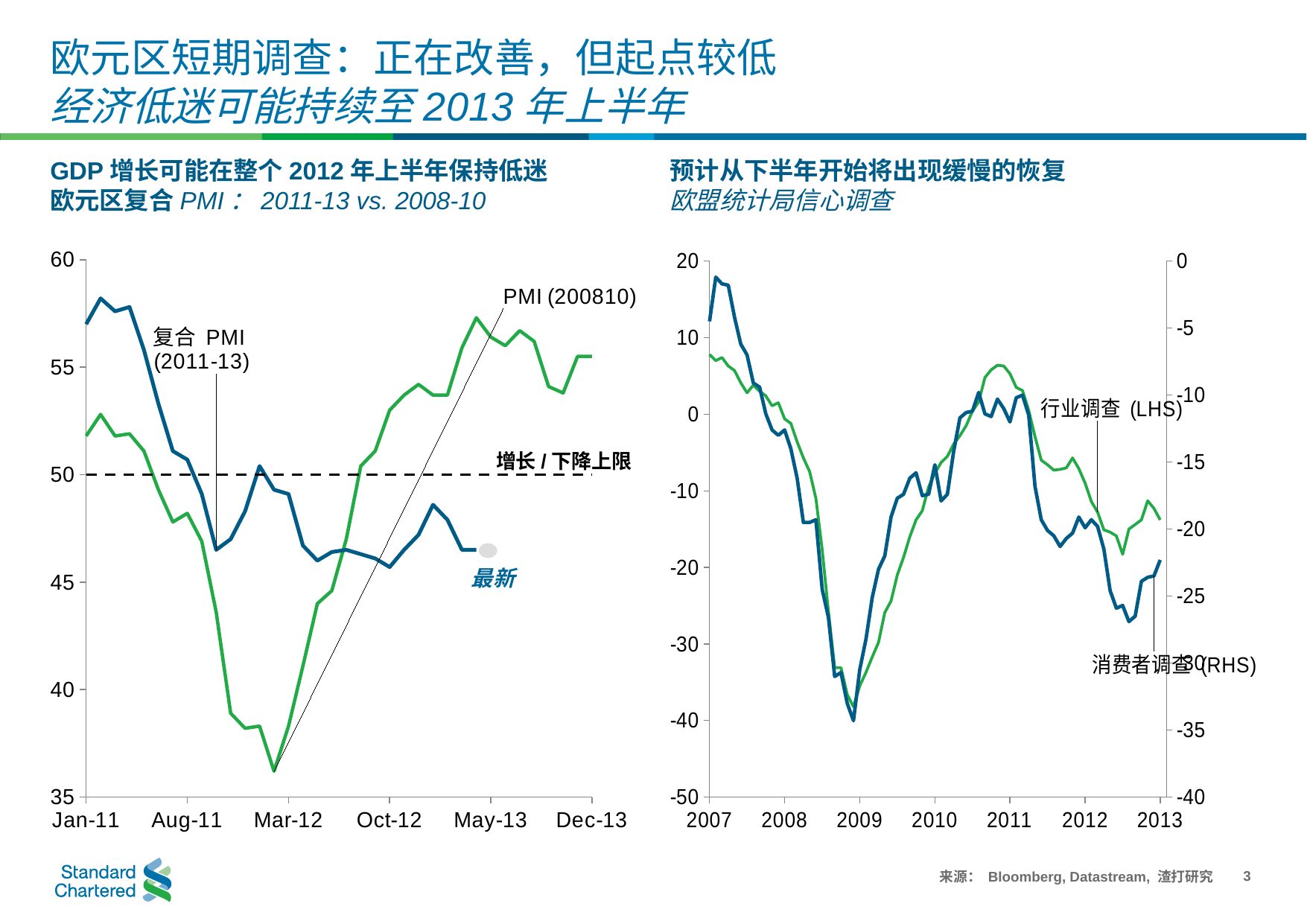
What kind of chart is the right chart (欧盟统计局信心调查)? line chart What kind of chart is the left chart (欧元区复合 PMI: 2011-13 vs. 2008-10)? line chart In the left chart, how many PMI series are plotted (excluding the dashed threshold line)? 2 In the left chart, what is the label of the dashed horizontal line at 50? 增长 / 下降上限 In the right chart, how many series are plotted? 2 In the left chart, is the latest (最新) value of 复合 PMI (2011-13) greater or less than 50? less In the right chart, is the lowest value of 行业调查 (LHS) around 2009 greater or less than -30? less In the right chart, does 行业调查 (LHS) rise or fall between 2009 and 2011? rise In the left chart, is the lowest value of PMI (200810) greater or less than 40? less In the right chart, which series is plotted on the right-hand axis (RHS)? 消费者调查 In the left chart, does 复合 PMI (2011-13) rise or fall between Jan-11 and Aug-11? fall